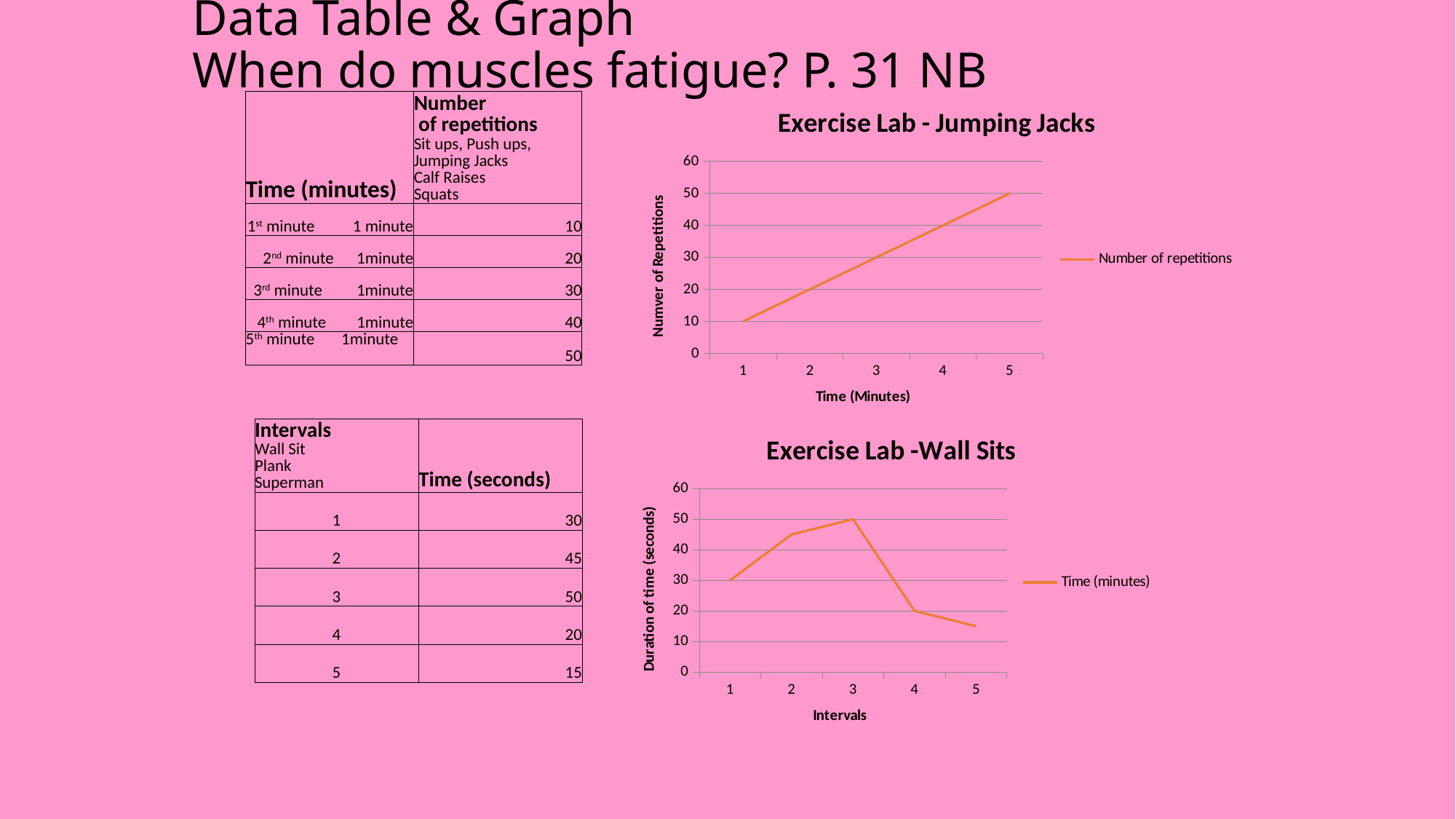
In the 'Exercise Lab - Jumping Jacks' chart, do the values rise or fall as time increases? rise In the 'Exercise Lab - Jumping Jacks' chart, what is the difference in repetitions between minute 5 and minute 1? 40 In the 'Exercise Lab -Wall Sits' chart, what is the legend entry? Time (minutes) In the 'Exercise Lab -Wall Sits' chart, what is the duration at interval 3? 50 In the 'Exercise Lab -Wall Sits' chart, how many intervals are plotted on the x axis? 5 In the 'Exercise Lab -Wall Sits' chart, which interval has the lowest duration? 5 In the 'Exercise Lab - Jumping Jacks' chart, what is the number of repetitions at minute 3? 30 What kind of chart is 'Exercise Lab - Jumping Jacks'? line chart In the 'Exercise Lab -Wall Sits' chart, what is the duration at interval 5? 15 In the 'Exercise Lab - Jumping Jacks' chart, what is the number of repetitions at minute 5? 50 In the 'Exercise Lab -Wall Sits' chart, which interval has the highest duration? 3 In the 'Exercise Lab -Wall Sits' chart, is the value at interval 4 greater or less than 30? less